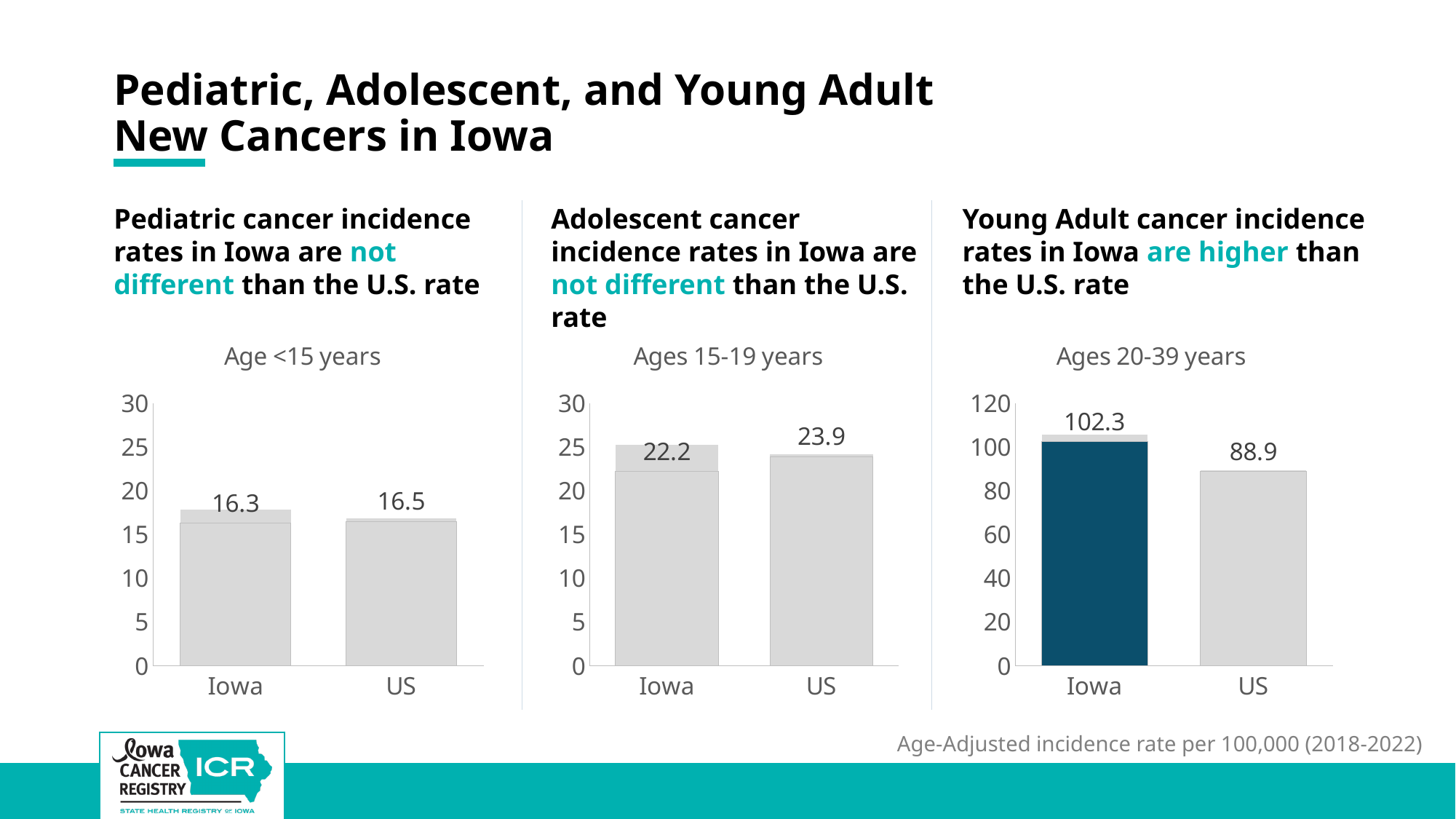
In the 'Ages 15-19 years' chart, what is the value for US? 23.9 In the 'Ages 15-19 years' chart, what is the value for Iowa? 22.2 In the 'Age <15 years' chart, what is the value for US? 16.5 In the 'Ages 15-19 years' chart, what is the difference between the US and Iowa values? 1.7 In the 'Ages 20-39 years' chart, which category has the higher value, Iowa or US? Iowa What type of chart is the 'Ages 20-39 years' chart? Bar chart How many bars are shown in the 'Age <15 years' chart? 2 In the 'Ages 15-19 years' chart, which category has the lower value? Iowa In the 'Ages 20-39 years' chart, what is the value for US? 88.9 In the 'Ages 20-39 years' chart, what is the value for Iowa? 102.3 In the 'Ages 20-39 years' chart, what is the difference between the Iowa and US values? 13.4 In the 'Age <15 years' chart, what is the value for Iowa? 16.3